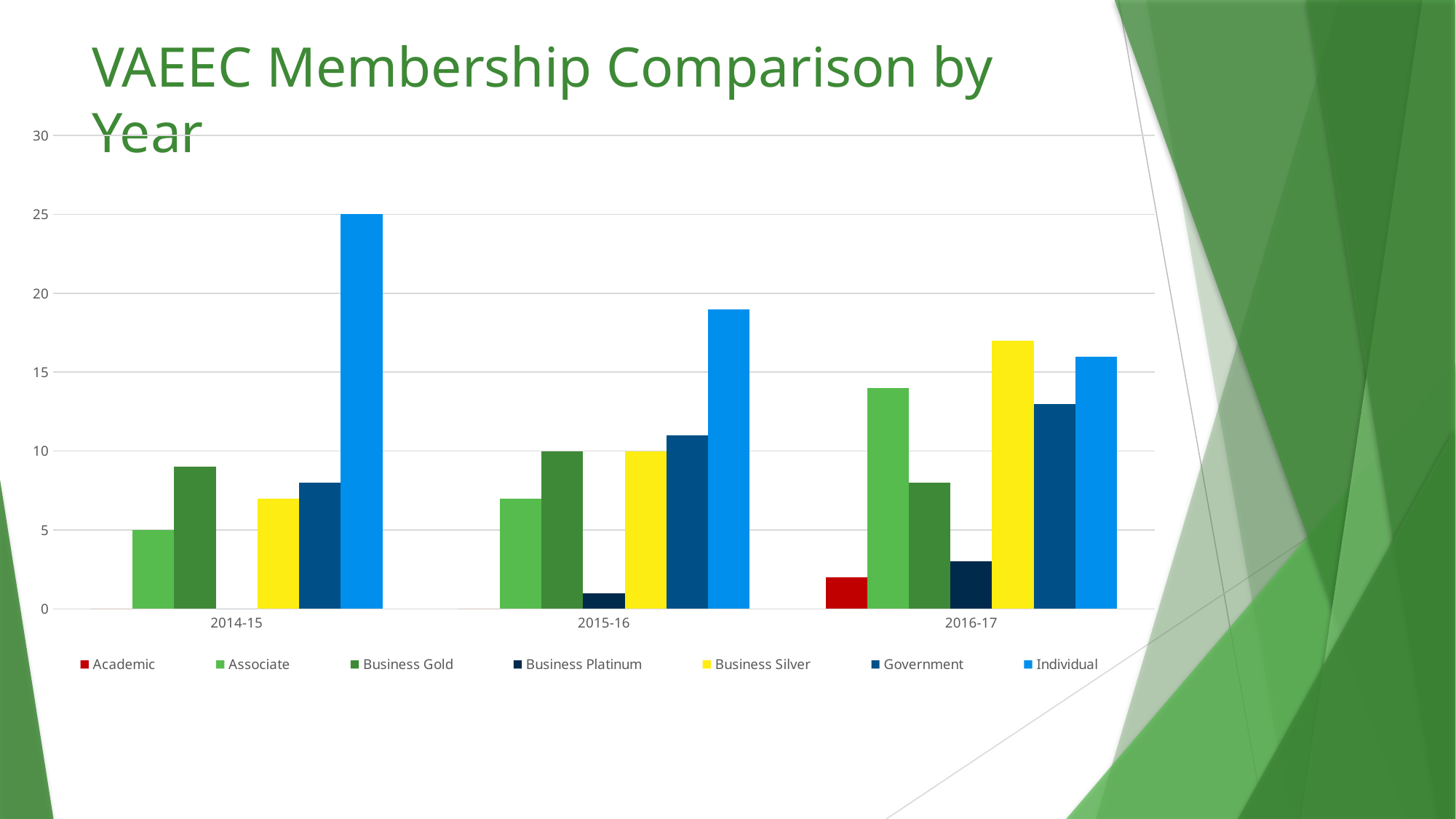
What is the value for Associate in 2014-15? 5 Which is larger in 2016-17, Associate or Business Gold? Associate Is the value for Individual in 2015-16 greater or less than 15? greater Which series has the highest value in 2016-17? Business Silver Which series has the lowest value in 2016-17? Academic Which series has the highest value in 2014-15? Individual What is the value for Business Gold in 2015-16? 10 How many series does the legend list? 7 What is the value for Individual in 2014-15? 25 Does the value for Individual rise or fall from 2014-15 to 2016-17? fall How many year categories are shown on the x axis? 3 What type of chart is shown on the slide? bar chart